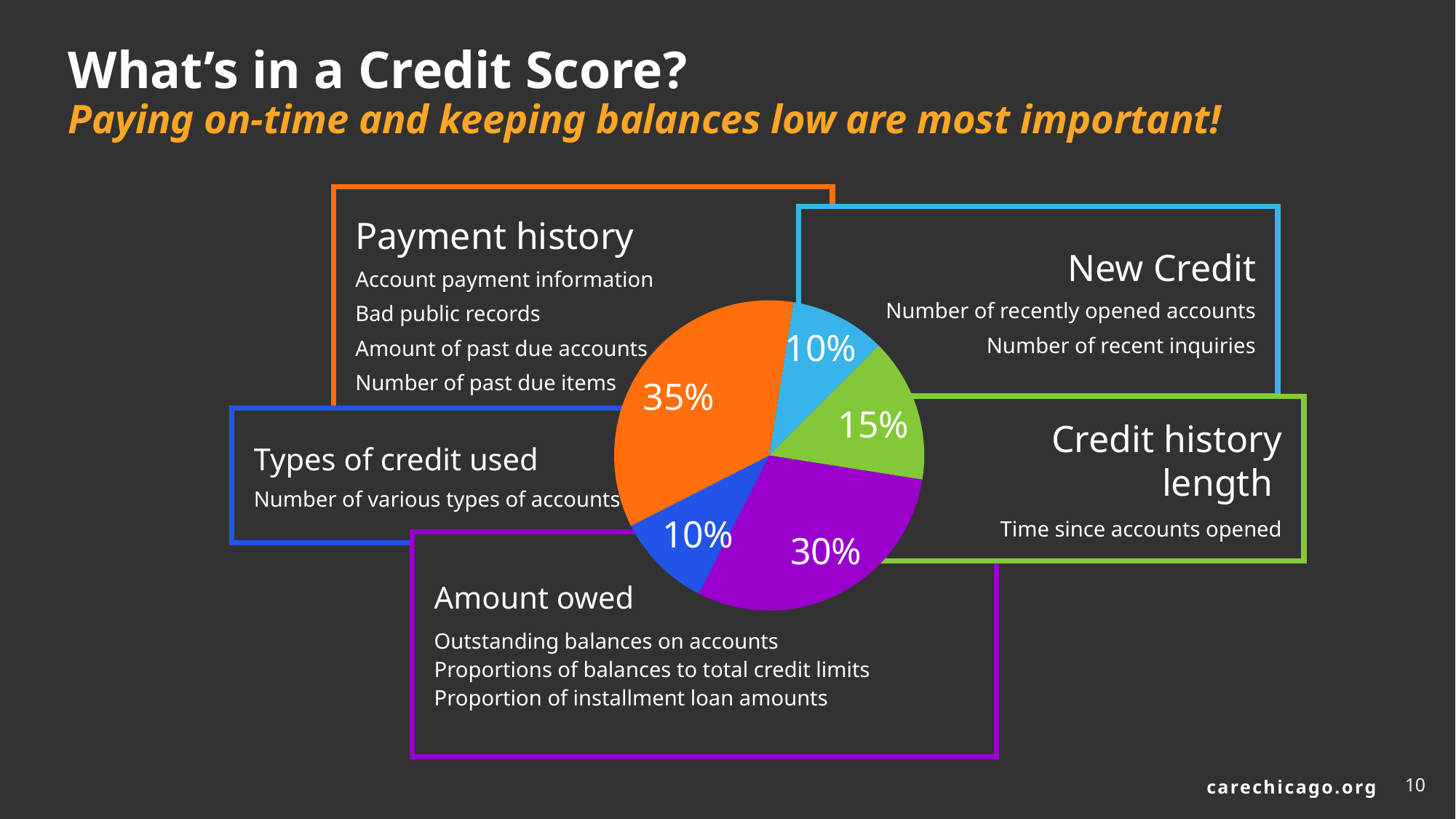
Which is larger, the slice for Amount owed or the slice for Credit history length? Amount owed What share of the credit score does Credit history length account for? 15% What share of the credit score does Amount owed account for? 30% What share of the credit score does Types of credit used account for? 10% How many slices does the pie chart have? 5 What is the difference in percentage points between Payment history and Amount owed? 5% What colour is the Payment history slice of the pie chart? orange Which factor has the largest slice of the pie chart? Payment history What is the combined share of Payment history and Amount owed? 65% What share of the credit score does New Credit account for? 10% What kind of chart is shown on the slide? pie chart What share of the credit score does Payment history account for? 35%